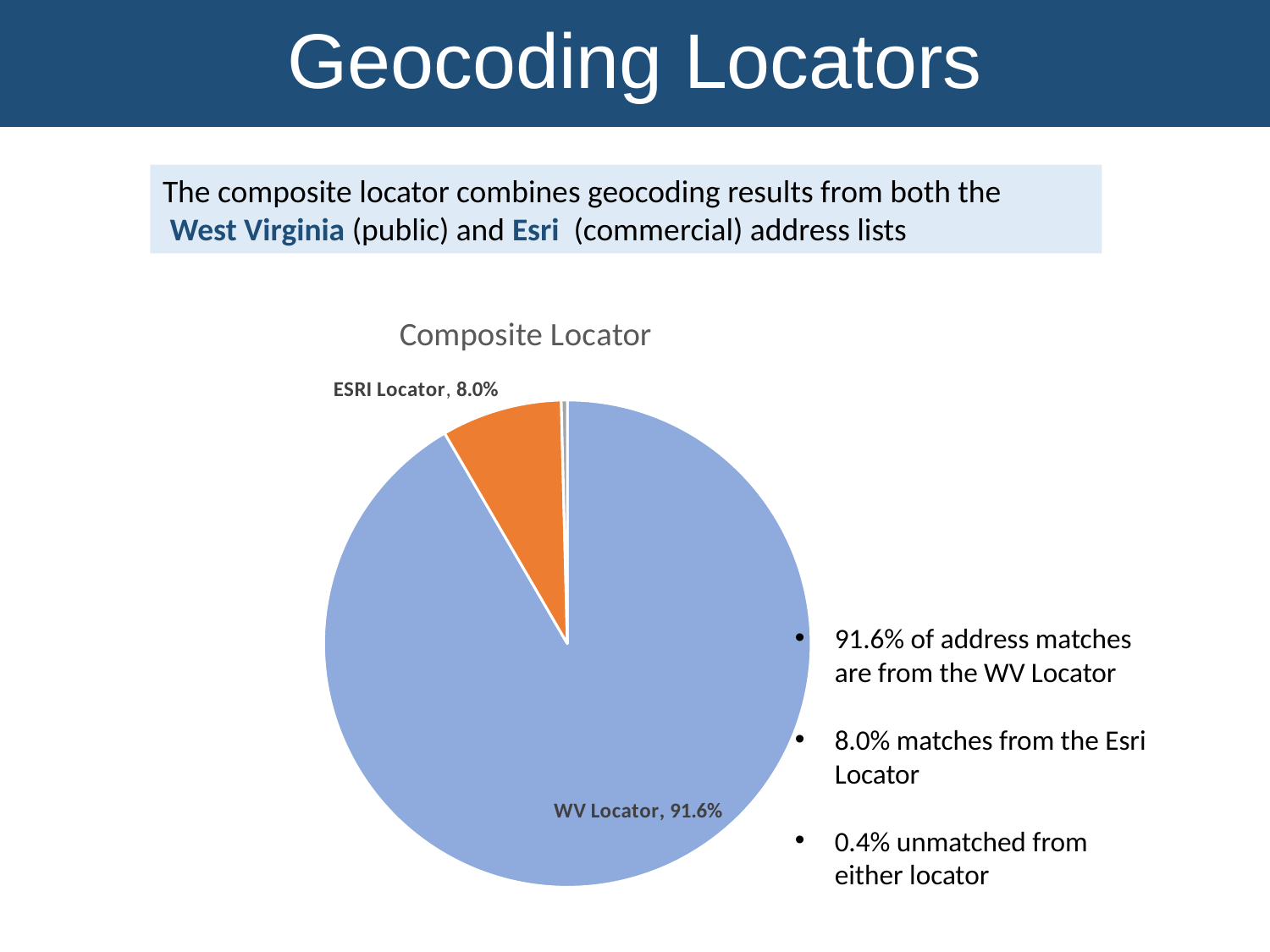
Is the share for the WV Locator slice greater or less than 90%? greater How many slices in the pie chart have a printed data label? 2 What kind of chart is shown on the slide? Pie chart Is the share for the ESRI Locator slice greater or less than 10%? less What is the difference in percentage points between the WV Locator and ESRI Locator slices? 83.6 What share of the pie does the ESRI Locator slice represent? 8.0% Which labeled slice of the pie is the smallest? ESRI Locator Which labeled slice of the pie is the largest? WV Locator What share of the pie does the WV Locator slice represent? 91.6% What is the title of the pie chart? Composite Locator Which is larger, the WV Locator slice or the ESRI Locator slice? WV Locator What colour is the WV Locator slice? Blue